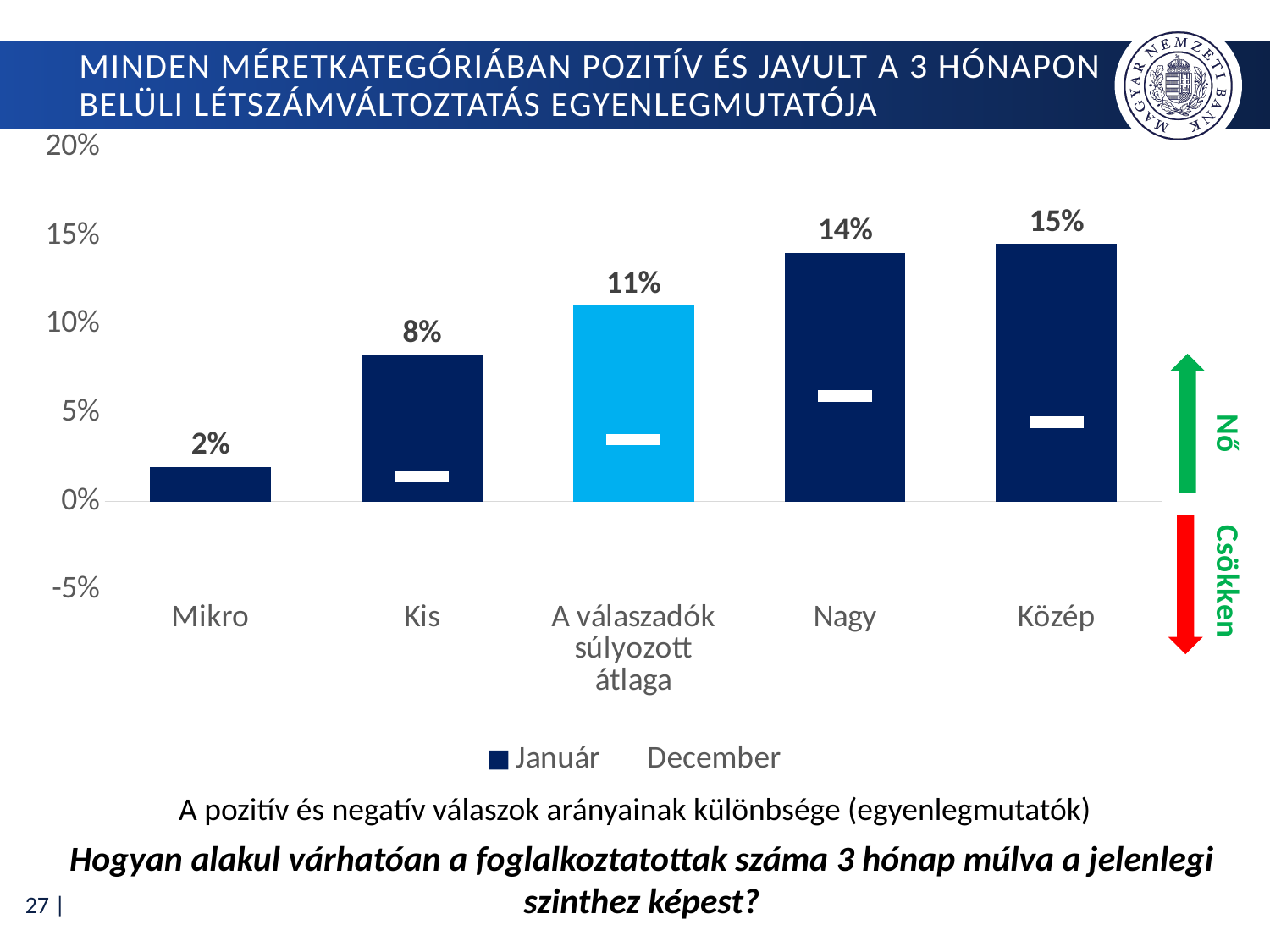
Is the December value for Nagy greater or less than 10%? less What kind of chart is shown on the slide? bar chart What is the Január value for Kis? 8% How many categories are shown on the x axis? 5 What is the Január value for Közép? 15% What is the Január value for Mikro? 2% What is the Január value for Nagy? 14% What is the Január value for A válaszadók súlyozott átlaga? 11% How many series does the legend list? 2 Which category has the lowest Január value? Mikro What is the difference between the Január values for Közép and Mikro? 13% Which has a larger Január value, Kis or Nagy? Nagy